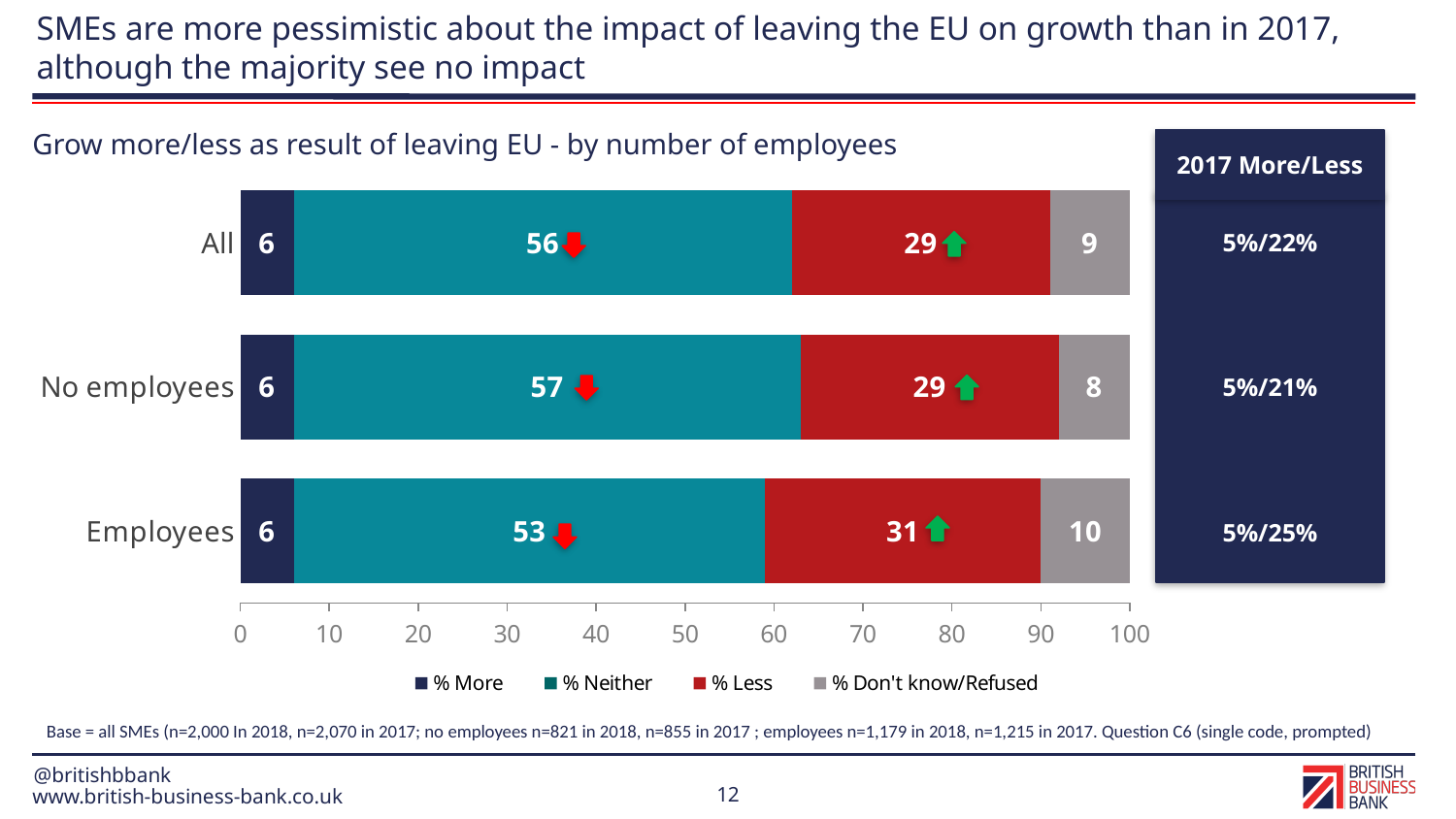
What is the title of the chart? Grow more/less as result of leaving EU - by number of employees How many series does the legend list? 4 What is the difference between the % Neither values for No employees and Employees? 4 Which category has the lowest % Don't know/Refused value? No employees What is the % Neither value for the All category? 56 Which category has the highest % Neither value? No employees What kind of chart is shown on the slide? Stacked bar chart What is the % More value for the Employees category? 6 What is the % Don't know/Refused value for No employees? 8 What is the % Less value for the Employees category? 31 How many categories are shown on the chart? 3 Is the % Less value larger for Employees or for No employees? Employees